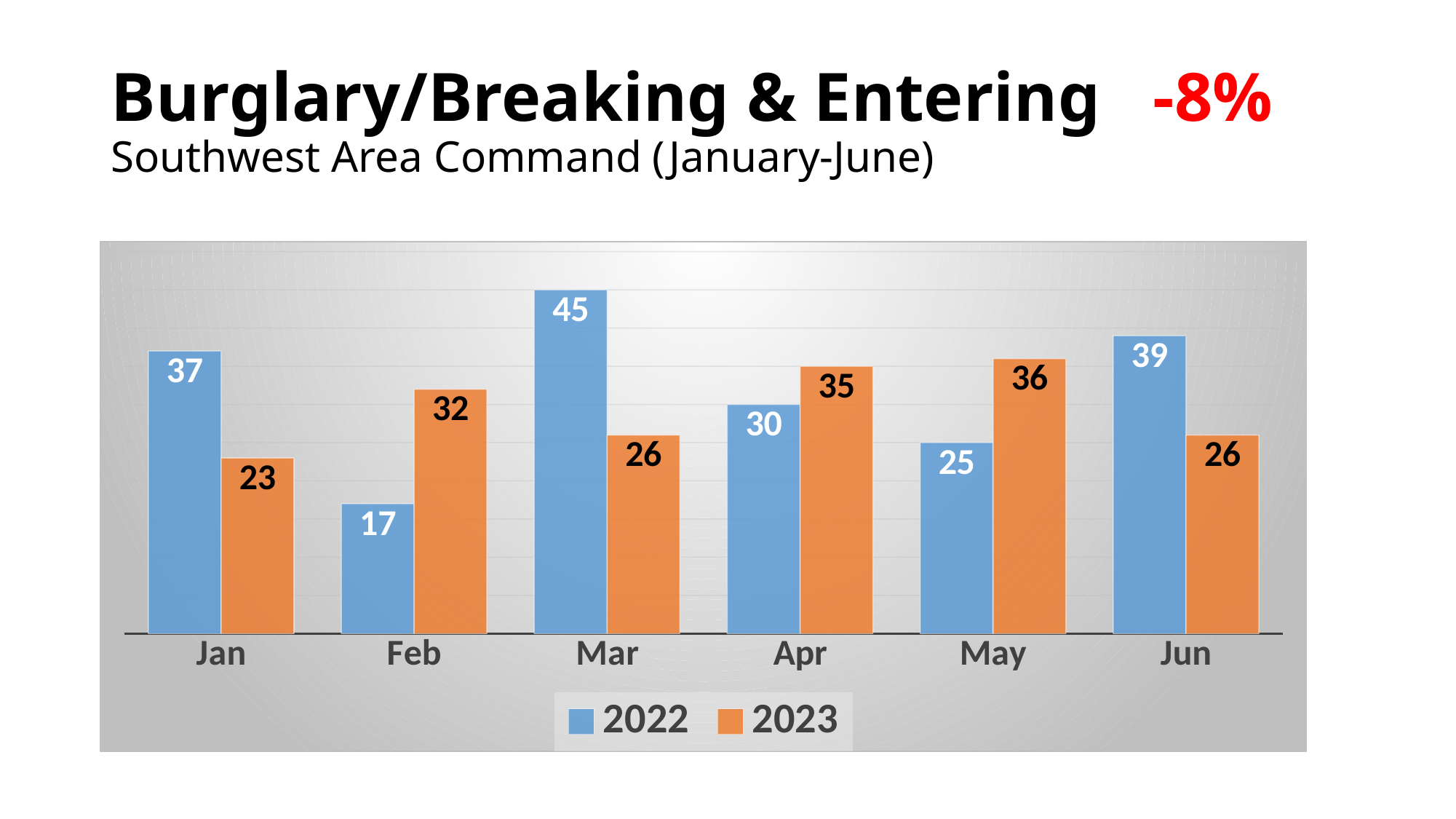
How many series does the legend list? 2 What kind of chart is shown on the slide? bar chart How many months are shown on the x axis? 6 What is the difference between the 2022 and 2023 values in Mar? 19 What is the value for 2023 in Feb? 32 What percentage change is shown in red next to the title? -8% What is the value for 2023 in Jun? 26 Which is larger in Apr, the 2022 value or the 2023 value? 2023 What is the value for 2022 in Mar? 45 Which month has the highest value for 2022? Mar Which month has the lowest value for 2022? Feb Which month has the highest value for 2023? May